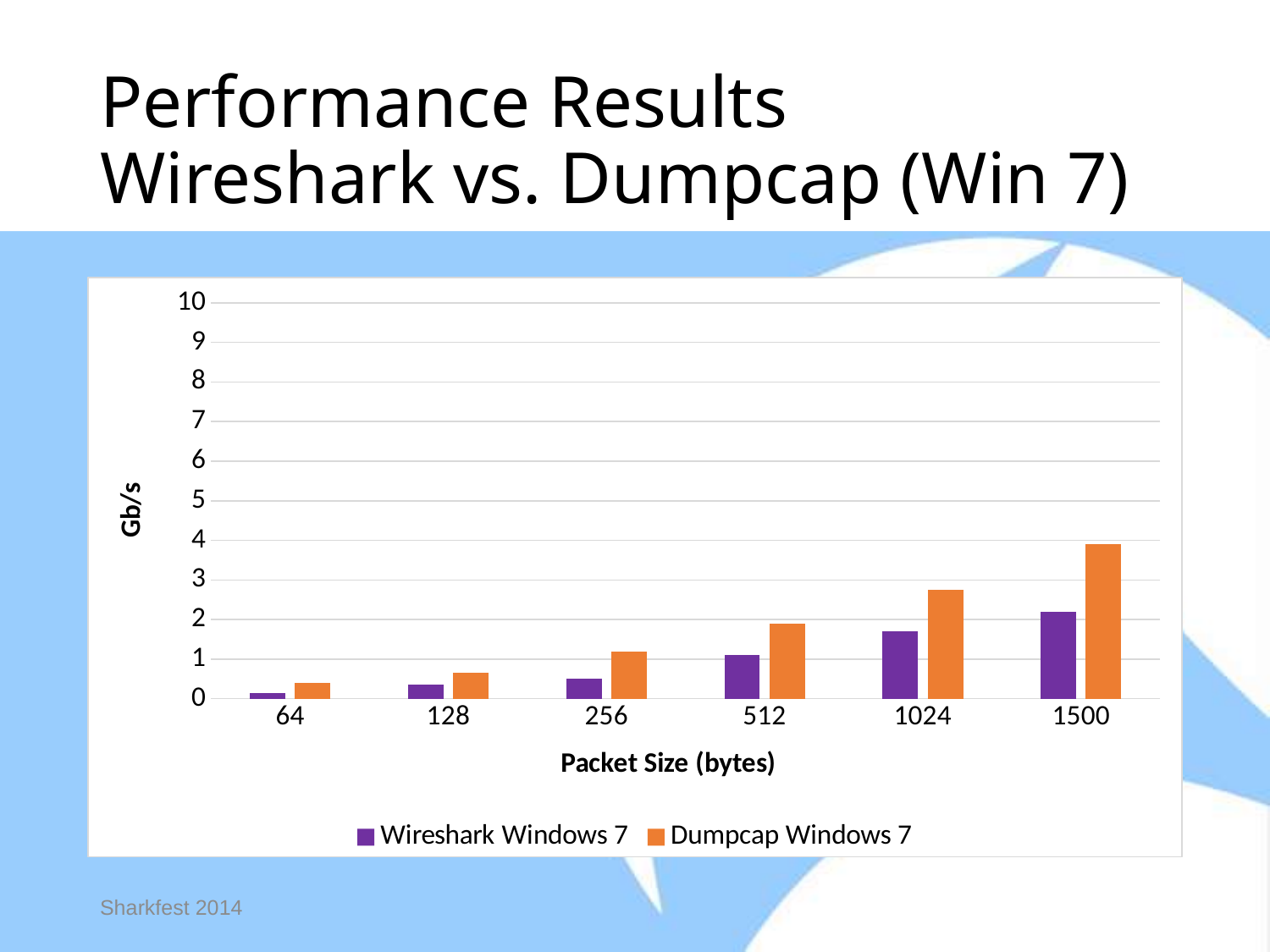
Do the Dumpcap Windows 7 values rise or fall as packet size increases along the x axis? rise At a packet size of 1024 bytes, which series has the larger value, Wireshark Windows 7 or Dumpcap Windows 7? Dumpcap Windows 7 Is the value for Wireshark Windows 7 at 1500 bytes greater or less than 3? less Is the value for Dumpcap Windows 7 at 1500 bytes greater or less than 3? greater Which packet size has the lowest value for Wireshark Windows 7? 64 Which packet size has the highest value for Dumpcap Windows 7? 1500 How many packet size categories are shown on the x axis? 6 How many series does the legend list? 2 What is the label of the y axis? Gb/s What type of chart is shown on the slide? bar chart Is the value for Wireshark Windows 7 at 512 bytes greater or less than 2? less